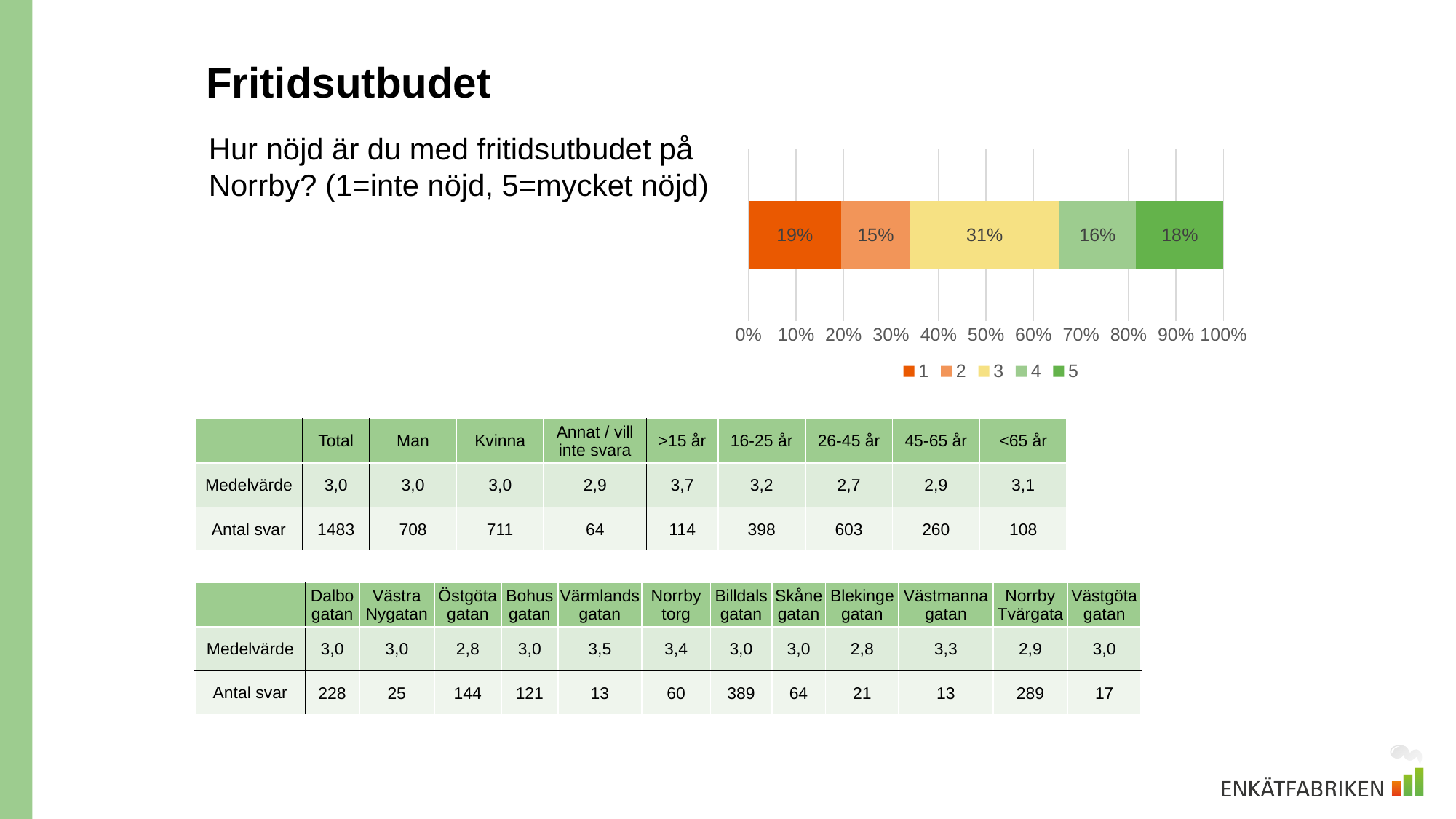
What is the highest value shown on the x axis of the stacked bar chart? 100% What share of respondents gave a rating of 5 in the stacked bar chart? 18% How many series does the legend of the stacked bar chart list? 5 What share of respondents gave a rating of 1 in the stacked bar chart? 19% What type of chart is shown on the slide? Stacked bar chart Which rating has the largest share in the stacked bar chart? 3 Which has a larger share in the stacked bar chart, rating 1 or rating 5? 1 What is the combined share of ratings 4 and 5 in the stacked bar chart? 34% What share of respondents gave a rating of 2 in the stacked bar chart? 15% What share of respondents gave a rating of 3 in the stacked bar chart? 31% What is the difference in percentage points between the share for rating 3 and the share for rating 4? 15 Which rating has the smallest share in the stacked bar chart? 2